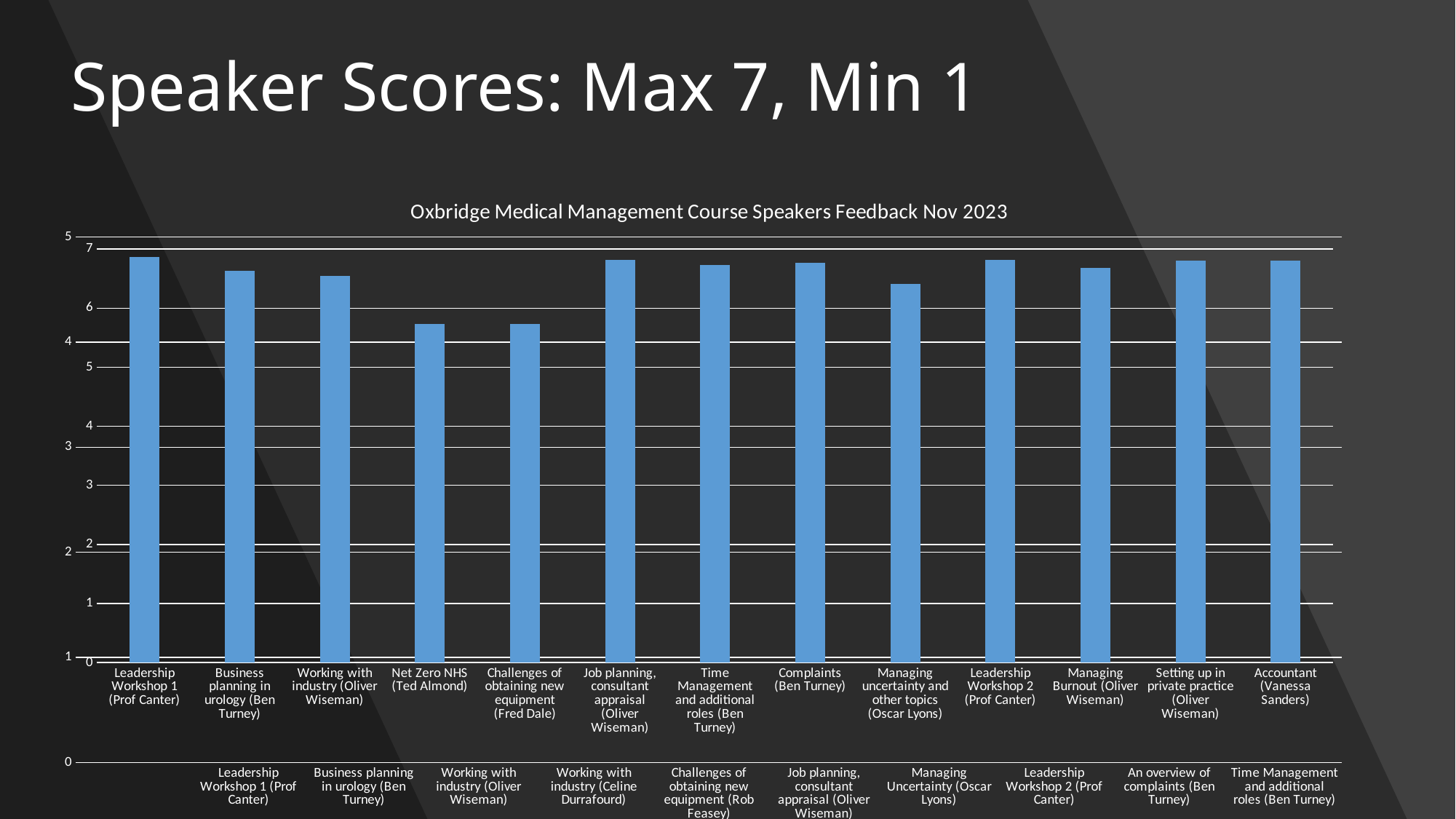
Is the value for Managing uncertainty and other topics (Oscar Lyons) greater or less than 6? greater What kind of chart is shown on the slide? bar chart Is the value for Leadership Workshop 1 (Prof Canter) greater or less than 6? greater Is the value for Accountant (Vanessa Sanders) greater or less than 5? greater What is the title of the chart on the slide? Oxbridge Medical Management Course Speakers Feedback Nov 2023 Which has the larger value: Net Zero NHS (Ted Almond) or Leadership Workshop 1 (Prof Canter)? Leadership Workshop 1 (Prof Canter) Which has the larger value: Business planning in urology (Ben Turney) or Challenges of obtaining new equipment (Fred Dale)? Business planning in urology (Ben Turney) How many bars are plotted in the Oxbridge Medical Management Course Speakers Feedback Nov 2023 chart? 13 What colour are the bars in the chart? blue Which has the larger value: Managing uncertainty and other topics (Oscar Lyons) or Net Zero NHS (Ted Almond)? Managing uncertainty and other topics (Oscar Lyons)